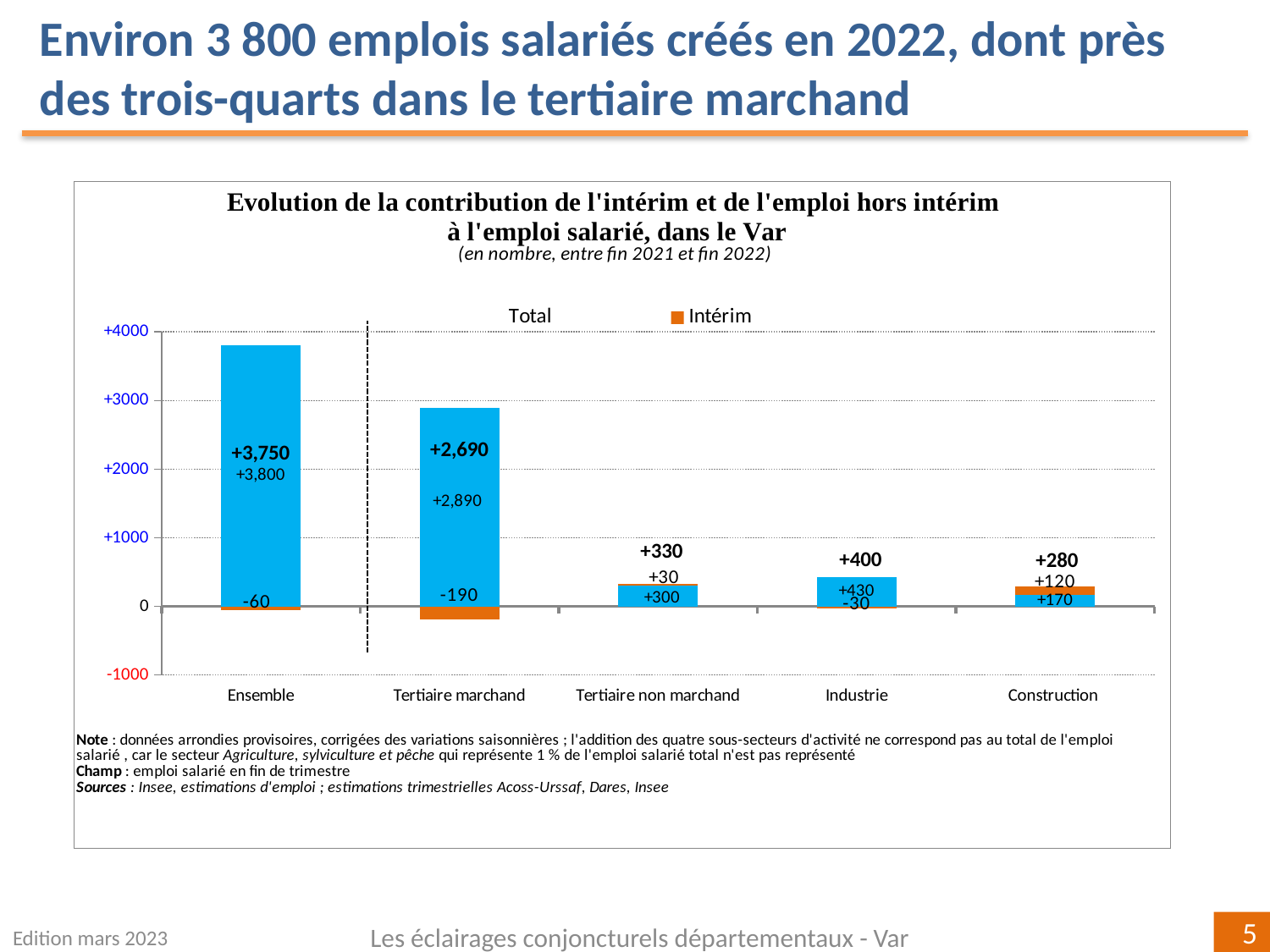
How many categories are shown on the x axis of the chart? 5 What kind of chart is shown on the slide? bar chart What is the total value (bold label) for Industrie? +400 What is the Intérim value for Ensemble? -60 Among the four sectors (excluding Ensemble), which has the highest total value? Tertiaire marchand What is the Intérim value for Tertiaire marchand? -190 Which has the larger Intérim value: Construction or Tertiaire non marchand? Construction What colour represents the Intérim series in the chart? orange Which category has the lowest total value (bold label)? Construction What is the difference between the total values for Tertiaire marchand (+2,690) and Industrie (+400)? 2,290 How many series does the chart legend list? 2 What is the total value (bold label) for Ensemble? +3,750